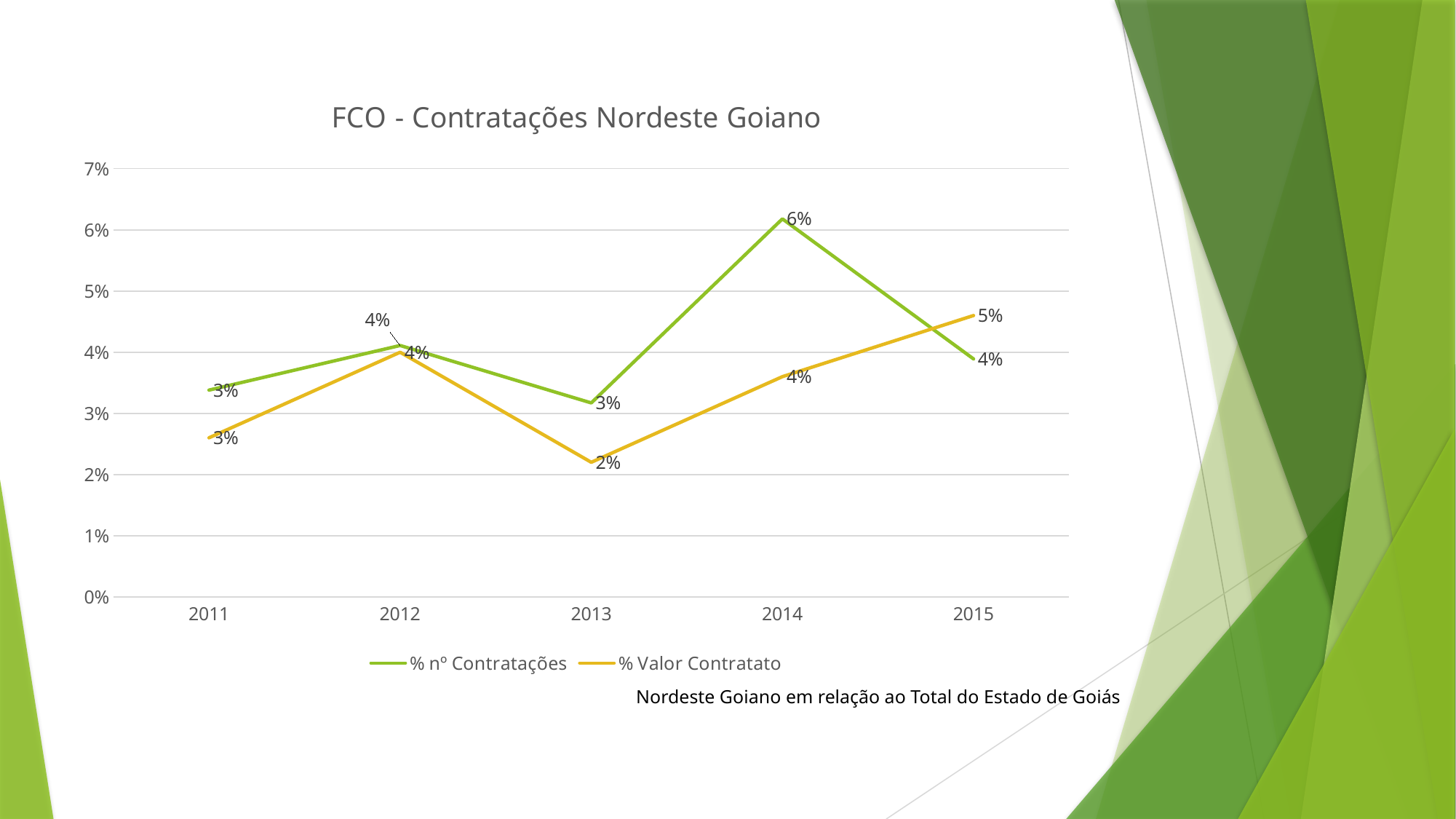
How many series does the legend list? 2 What is the difference between % nº Contratações and % Valor Contratato in 2014? 2% What is the value of % Valor Contratato in 2013? 2% What is the value of % nº Contratações in 2014? 6% What kind of chart is shown on the slide? line chart How many years are shown on the x axis? 5 In which year is % nº Contratações highest? 2014 In which year is % Valor Contratato highest? 2015 In 2015, which series has the larger value, % nº Contratações or % Valor Contratato? % Valor Contratato Is the value of % nº Contratações in 2014 greater or less than 5%? greater In which year is % Valor Contratato lowest? 2013 What is the value of % Valor Contratato in 2015? 5%